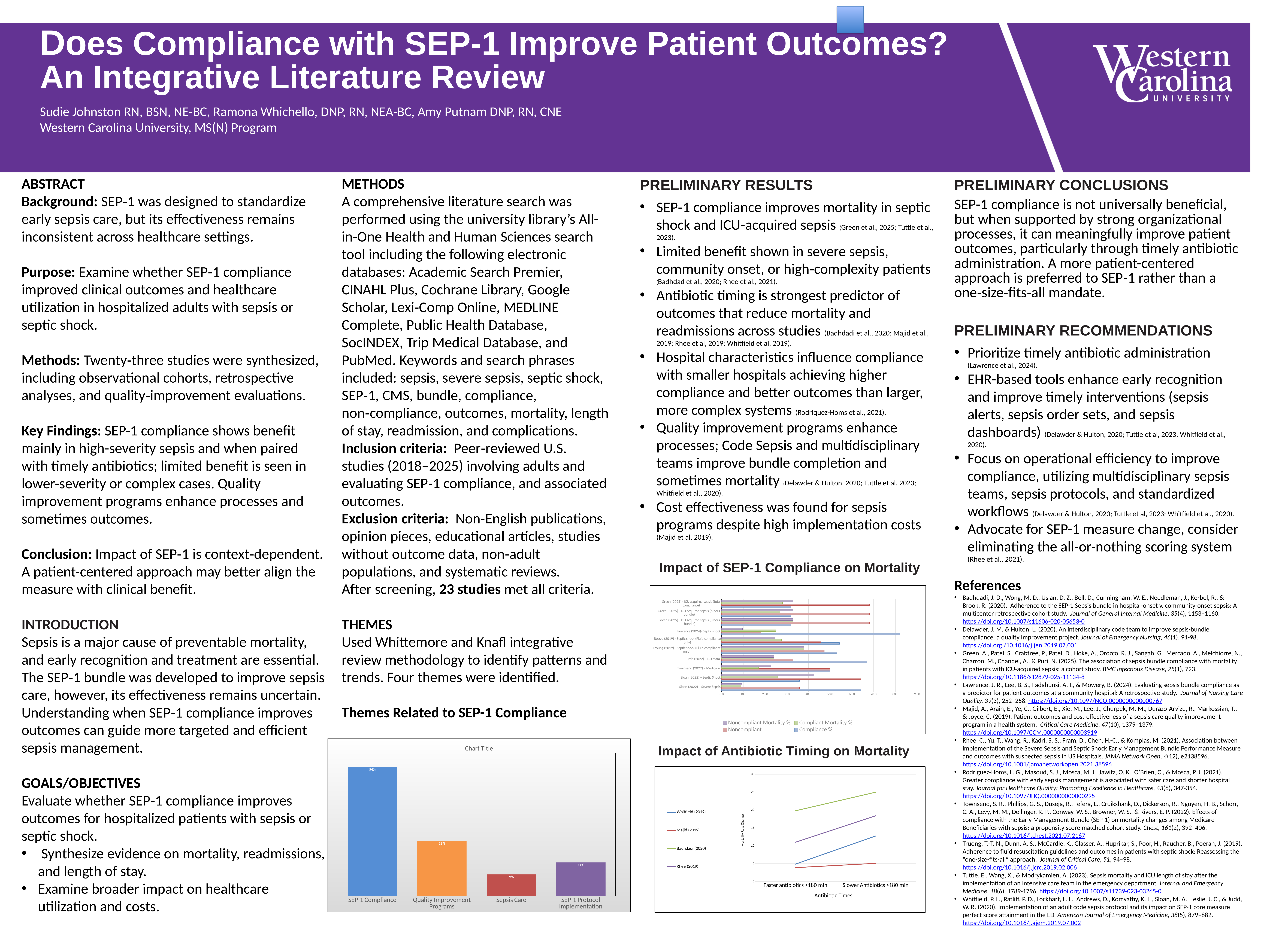
In the 'Impact of SEP-1 Compliance on Mortality' chart, is the Compliance % value for Lawrence (2024) - Septic shock greater or less than 70.0? greater In the 'Impact of SEP-1 Compliance on Mortality' chart, how many series does the legend list? 4 In the 'Themes Related to SEP-1 Compliance' chart, what is the value for SEP-1 Compliance? 54% What kind of chart is the 'Themes Related to SEP-1 Compliance' chart? Bar chart In the 'Themes Related to SEP-1 Compliance' chart, what is the value for Quality Improvement Programs? 23% In the 'Themes Related to SEP-1 Compliance' chart, which category has the highest value? SEP-1 Compliance In the 'Impact of Antibiotic Timing on Mortality' chart, which study's line is highest? Badhdadi (2020) In the 'Impact of Antibiotic Timing on Mortality' chart, do the lines rise or fall from faster antibiotics to slower antibiotics? Rise In the 'Impact of Antibiotic Timing on Mortality' chart, how many series does the legend list? 4 In the 'Themes Related to SEP-1 Compliance' chart, what is the difference between SEP-1 Compliance and SEP-1 Protocol Implementation? 40% In the 'Themes Related to SEP-1 Compliance' chart, how many categories are shown? 4 In the 'Themes Related to SEP-1 Compliance' chart, which category has the lowest value? Sepsis Care